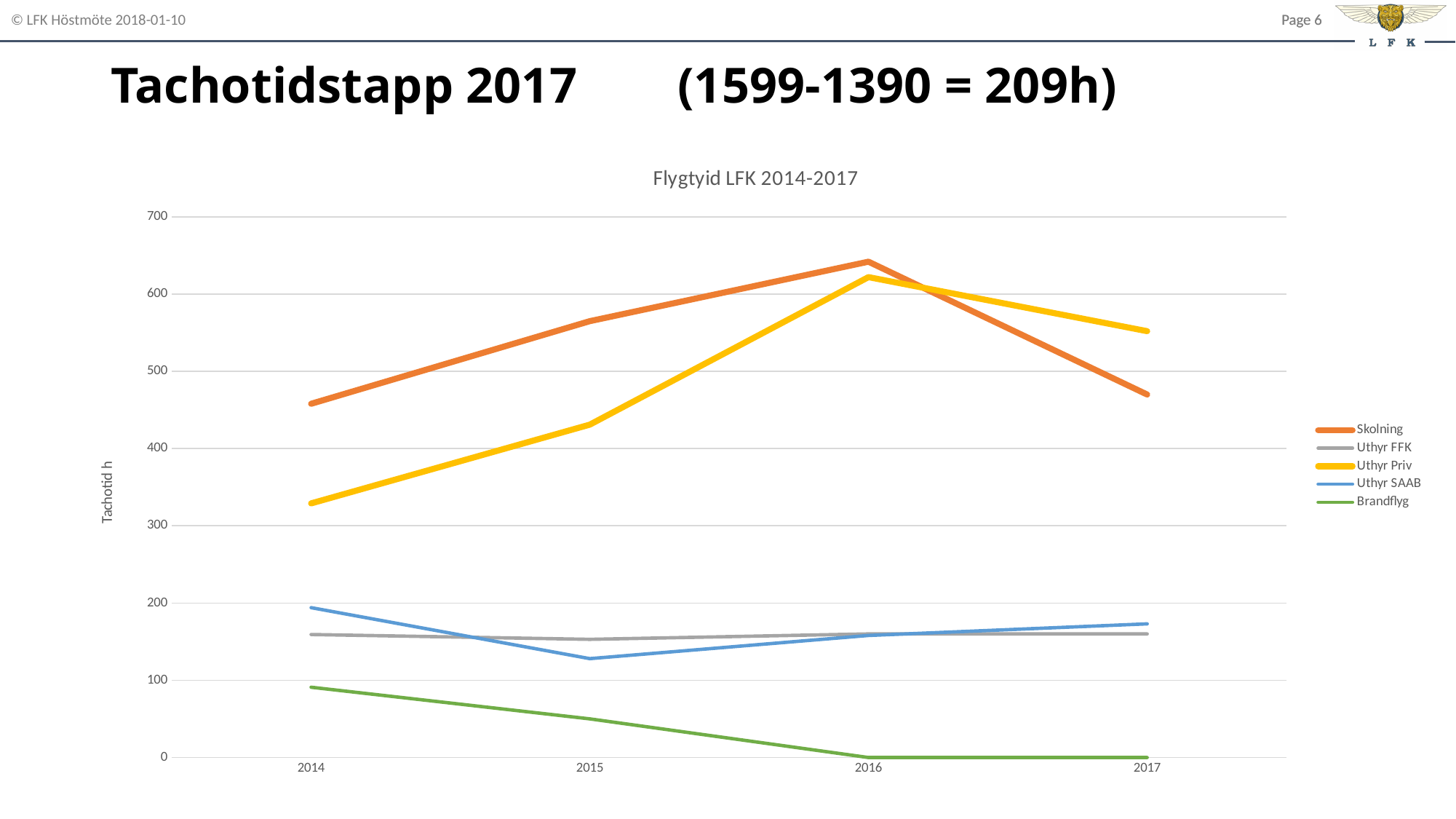
What kind of chart is shown on the slide? line chart Is the value for Uthyr Priv in 2014 greater or less than 400? less Which series has the highest value in 2017? Uthyr Priv How many series does the chart legend list? 5 Is the value for Skolning in 2016 greater or less than 600? greater Which series has the lowest value in 2014? Brandflyg How many years are plotted along the x axis? 4 In which year does Skolning reach its highest value? 2016 What is the label of the vertical axis? Tachotid h Is the value for Skolning in 2017 greater or less than 500? less What is the title of the chart? Flygtyid LFK 2014-2017 Does the Brandflyg series rise or fall from 2014 to 2016? fall